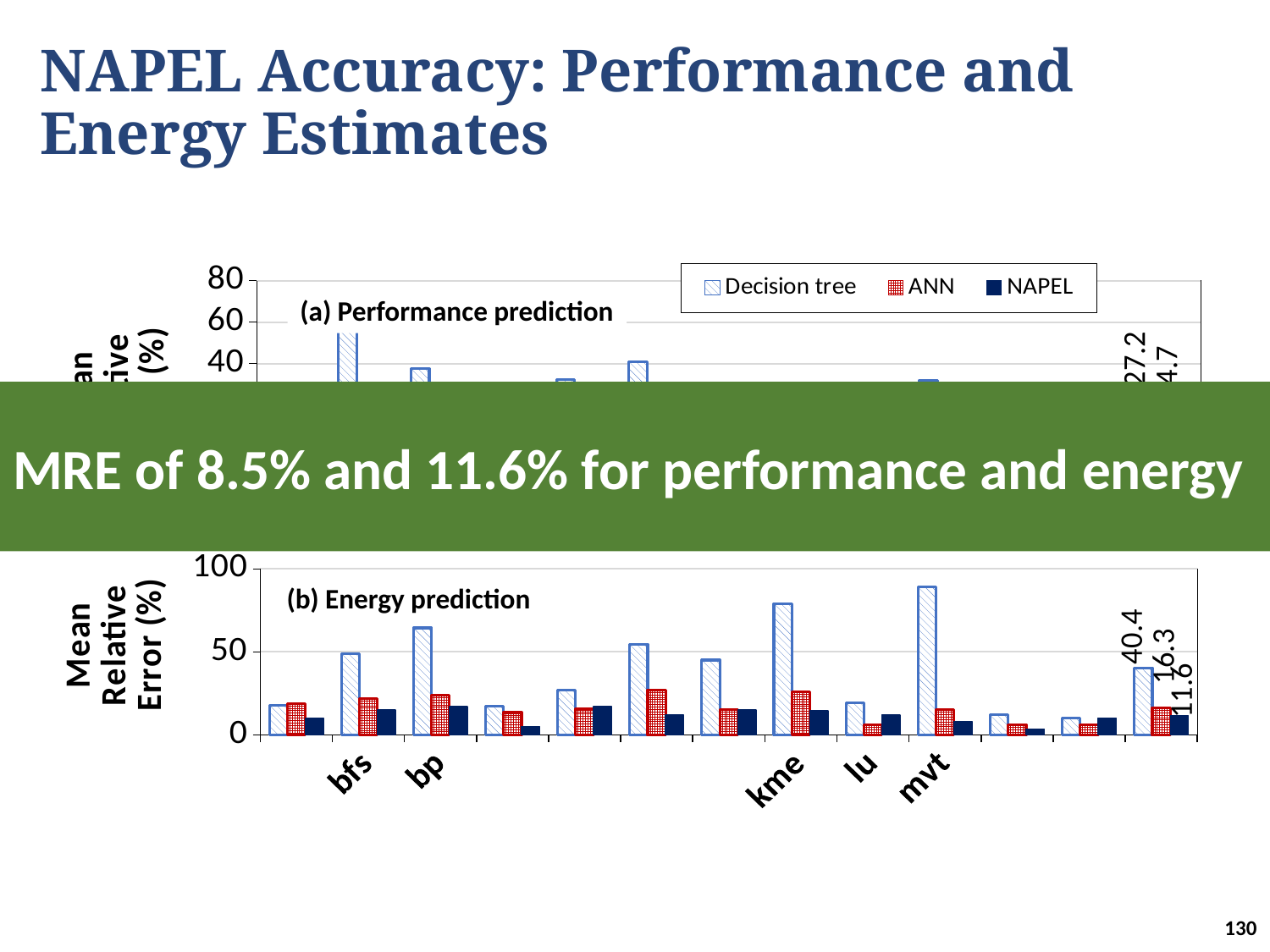
In the (b) Energy prediction chart, which is larger for bp: the Decision tree value or the NAPEL value? Decision tree How many series does the legend list? 3 In the (b) Energy prediction chart, what is the difference between the Decision tree and NAPEL values in the rightmost group of bars? 28.8 In the (b) Energy prediction chart, which labeled category has the highest Decision tree value? mvt In the (b) Energy prediction chart, what is the ANN value for the rightmost group of bars? 16.3 In the (b) Energy prediction chart, what is the NAPEL value for the rightmost group of bars? 11.6 In the (b) Energy prediction chart, is the Decision tree value for lu greater or less than 50? less What is the highest y-axis tick shown on the (b) Energy prediction chart? 100 In the (b) Energy prediction chart, what is the Decision tree value for the rightmost group of bars? 40.4 What are the three series named in the legend? Decision tree, ANN, NAPEL In the (b) Energy prediction chart, is the Decision tree value for mvt greater or less than 50? greater What kind of chart is the (b) Energy prediction chart? bar chart